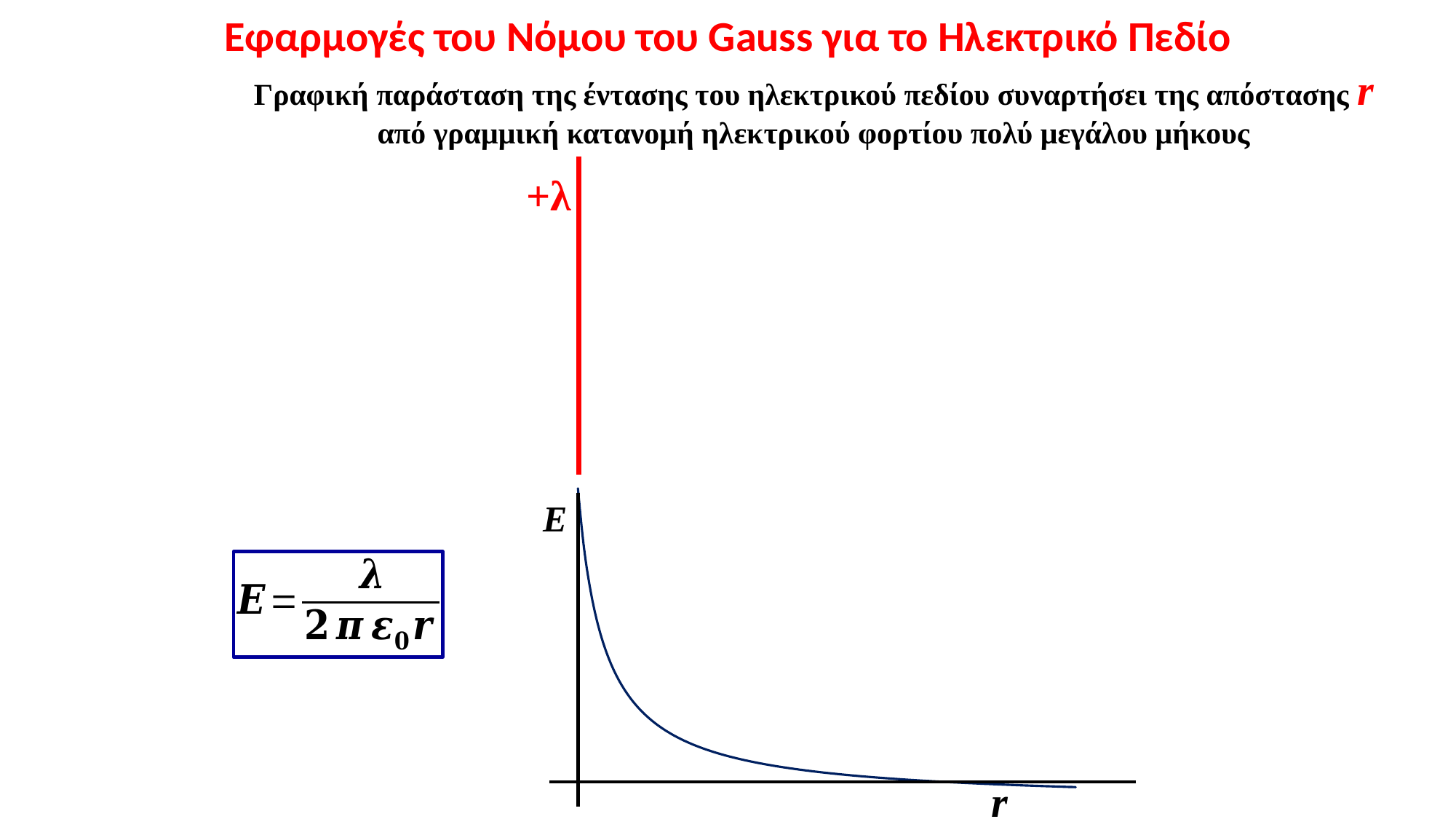
Is the plotted curve steeper near the vertical axis or far from it? near the vertical axis Does the plotted value of E rise or fall as r increases along the x axis? fall What is the label on the vertical axis of the graph? E What is the label on the horizontal axis of the graph? r How many curves are plotted on the graph? 1 What kind of chart is shown on the slide? line chart